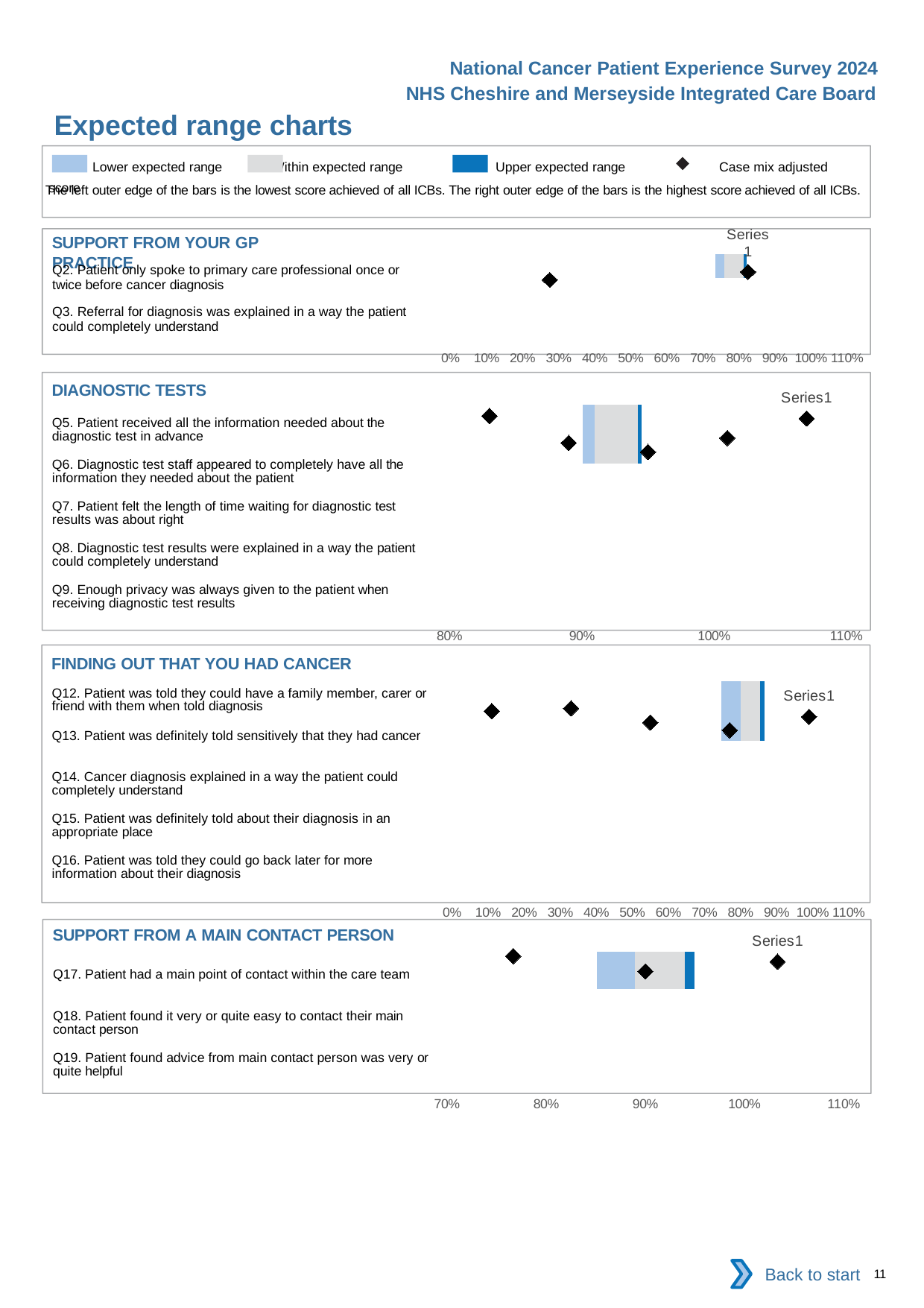
In the SUPPORT FROM YOUR GP PRACTICE chart, how many questions are listed? 2 In the DIAGNOSTIC TESTS chart, how many questions are listed? 5 How many charts are shown on the slide? 4 In the SUPPORT FROM YOUR GP PRACTICE chart, what is the highest value shown on the x axis? 110% In the SUPPORT FROM A MAIN CONTACT PERSON chart, is the left edge of the expected range bar greater or less than 80%? greater In the FINDING OUT THAT YOU HAD CANCER chart, is the left edge of the expected range bar greater or less than 70%? greater In the DIAGNOSTIC TESTS chart, what is the lowest value shown on the x axis? 80% How many entries does the legend at the top of the slide list? 4 In the SUPPORT FROM A MAIN CONTACT PERSON chart, what is the lowest value shown on the x axis? 70% According to the legend at the top of the slide, what does the diamond marker represent? Case mix adjusted score